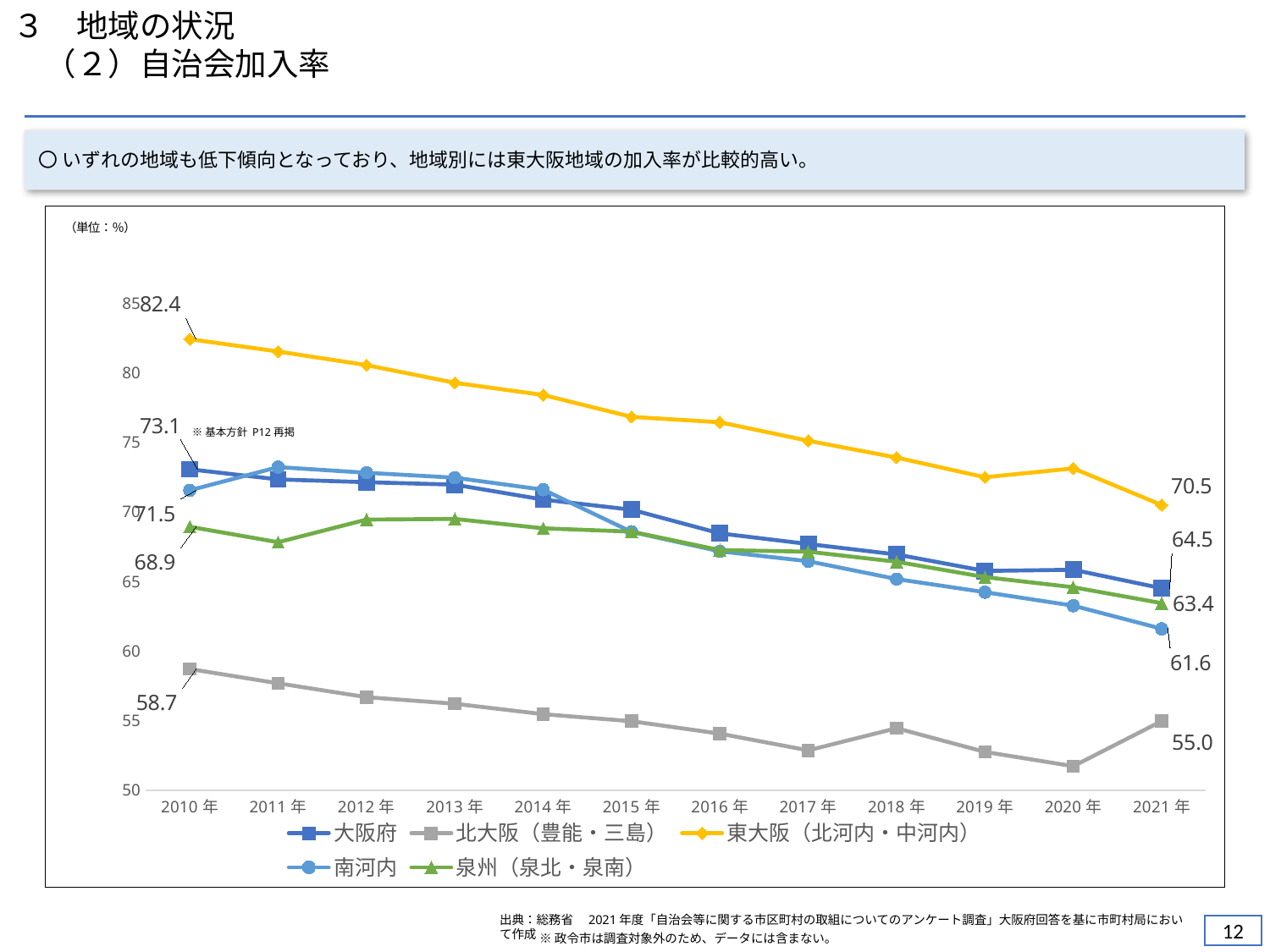
Does the value for 大阪府 rise or fall from 2010年 to 2021年? fall Is the value for 北大阪（豊能・三島） in 2020年 greater or less than 55? less What is the value for 北大阪（豊能・三島） in 2021年? 55.0 How many series does the legend list? 5 What is the value for 東大阪（北河内・中河内） in 2010年? 82.4 Which series has the highest value in 2021年? 東大阪（北河内・中河内） What is the value for 南河内 in 2010年? 71.5 What is the value for 大阪府 in 2021年? 64.5 By how much did the value for 東大阪（北河内・中河内） fall from 2010年 to 2021年? 11.9 What kind of chart is shown on the slide? line chart Which series has the lowest value in 2010年? 北大阪（豊能・三島） How many years are plotted along the x axis? 12